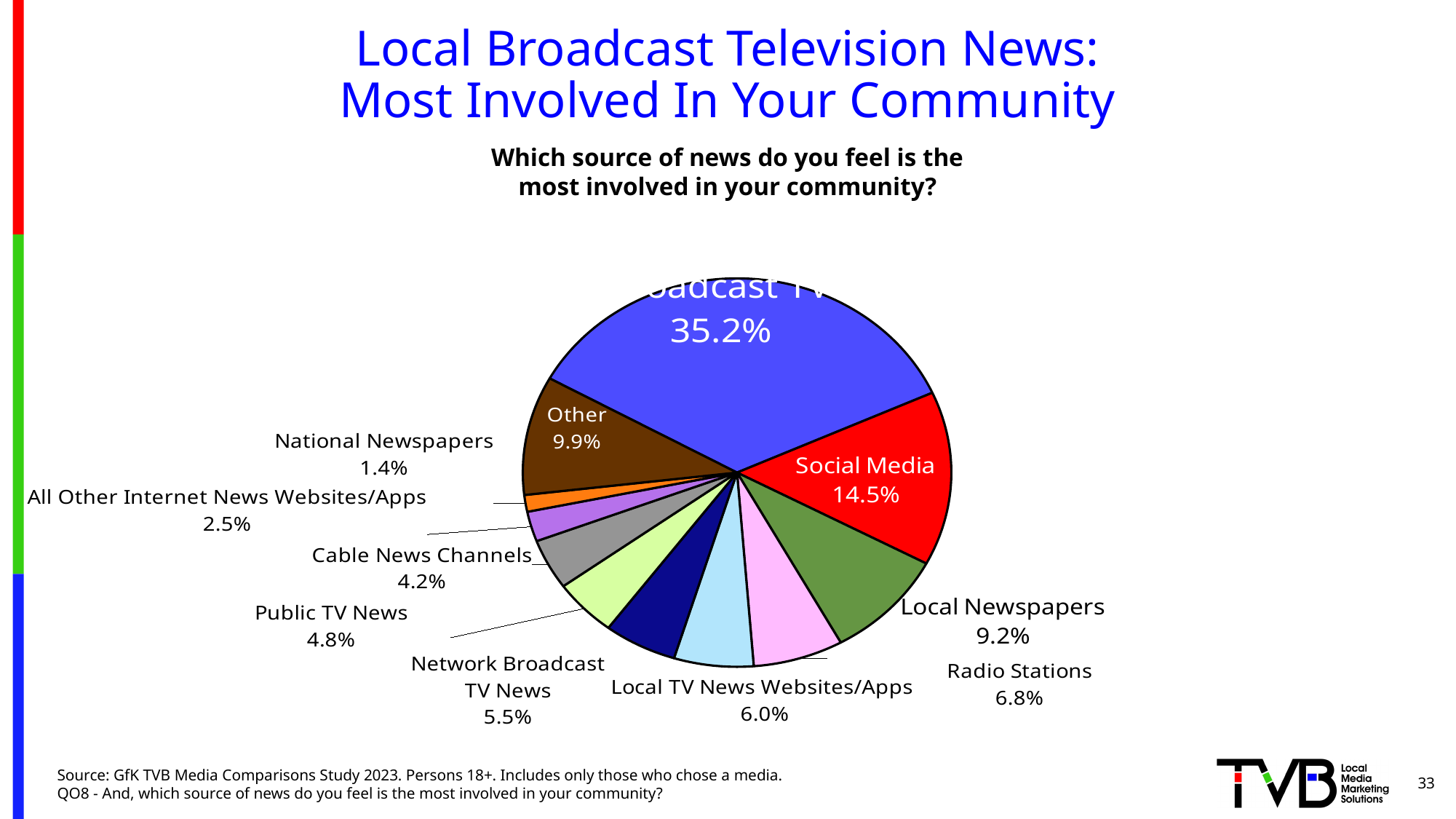
What percentage is shown for the Other slice? 9.9% What kind of chart is shown on the slide? pie chart What is the combined percentage of Local TV News Websites/Apps and All Other Internet News Websites/Apps? 8.5% Which is larger, the slice for Public TV News or the slice for Network Broadcast TV News? Network Broadcast TV News What is the percentage shown on the largest slice of the pie? 35.2% What share of respondents chose Social Media as the source most involved in their community? 14.5% What percentage is shown for Cable News Channels? 4.2% How many slices does the pie chart have? 11 What is the difference in percentage points between Social Media and Local Newspapers? 5.3 What percentage is shown for Radio Stations? 6.8% Which source has the smallest slice of the pie? National Newspapers What percentage is shown for Local Newspapers? 9.2%